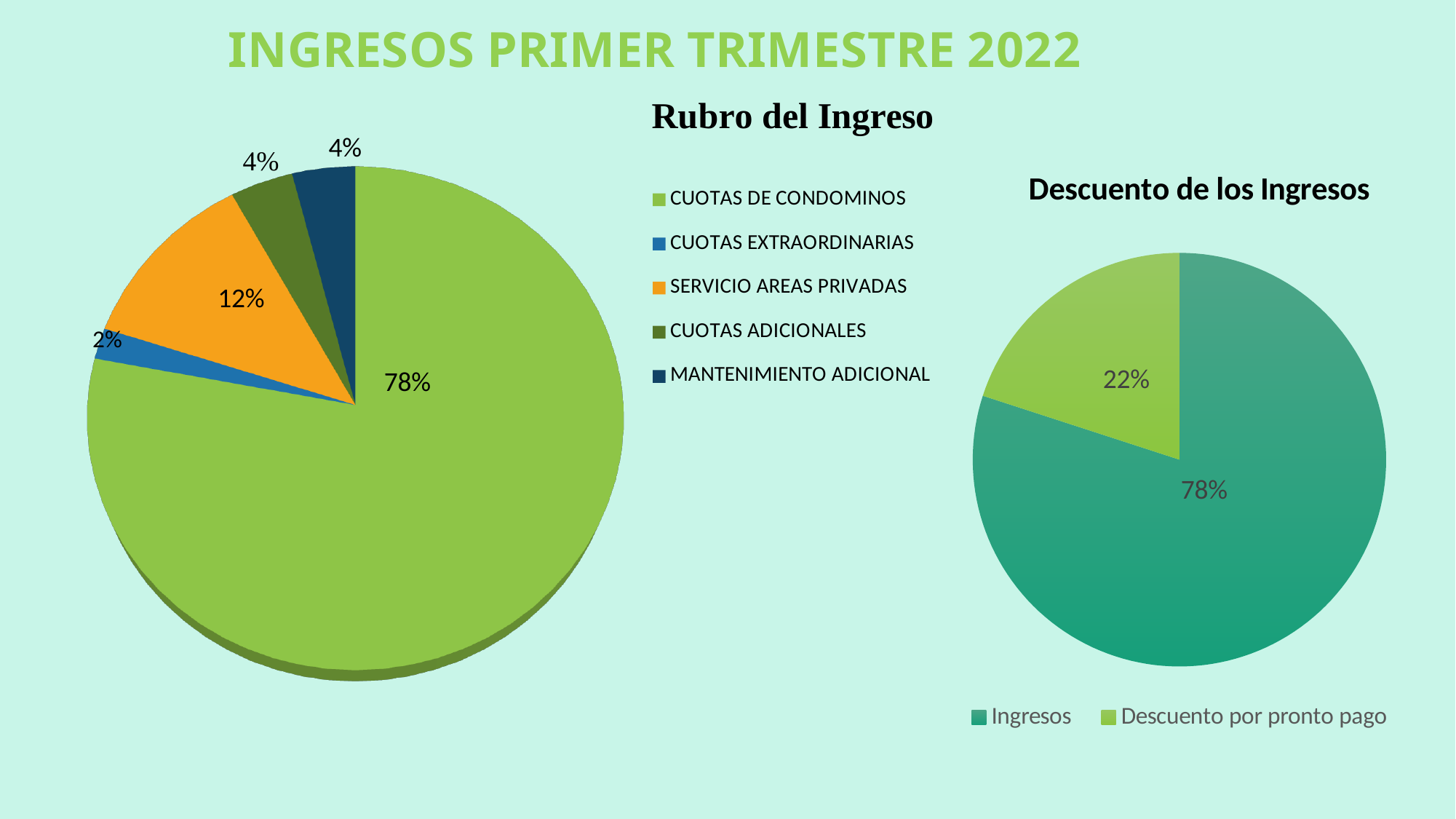
In the 'Rubro del Ingreso' chart, which category has the smallest slice? CUOTAS EXTRAORDINARIAS In the 'Rubro del Ingreso' chart, what share does CUOTAS DE CONDOMINOS have? 78% In the 'Rubro del Ingreso' chart, which is larger, SERVICIO AREAS PRIVADAS or CUOTAS ADICIONALES? SERVICIO AREAS PRIVADAS In the 'Rubro del Ingreso' chart, what is the difference between the shares of CUOTAS DE CONDOMINOS and SERVICIO AREAS PRIVADAS? 66% In the 'Descuento de los Ingresos' chart, what share does Descuento por pronto pago have? 22% In the 'Rubro del Ingreso' chart, what share does SERVICIO AREAS PRIVADAS have? 12% What kind of chart is 'Descuento de los Ingresos'? Pie chart In the 'Rubro del Ingreso' chart, how many categories are shown? 5 In the 'Descuento de los Ingresos' chart, what is the difference between the Ingresos and Descuento por pronto pago shares? 56% How many entries does the legend of the 'Descuento de los Ingresos' chart list? 2 In the 'Rubro del Ingreso' chart, which category has the largest slice? CUOTAS DE CONDOMINOS